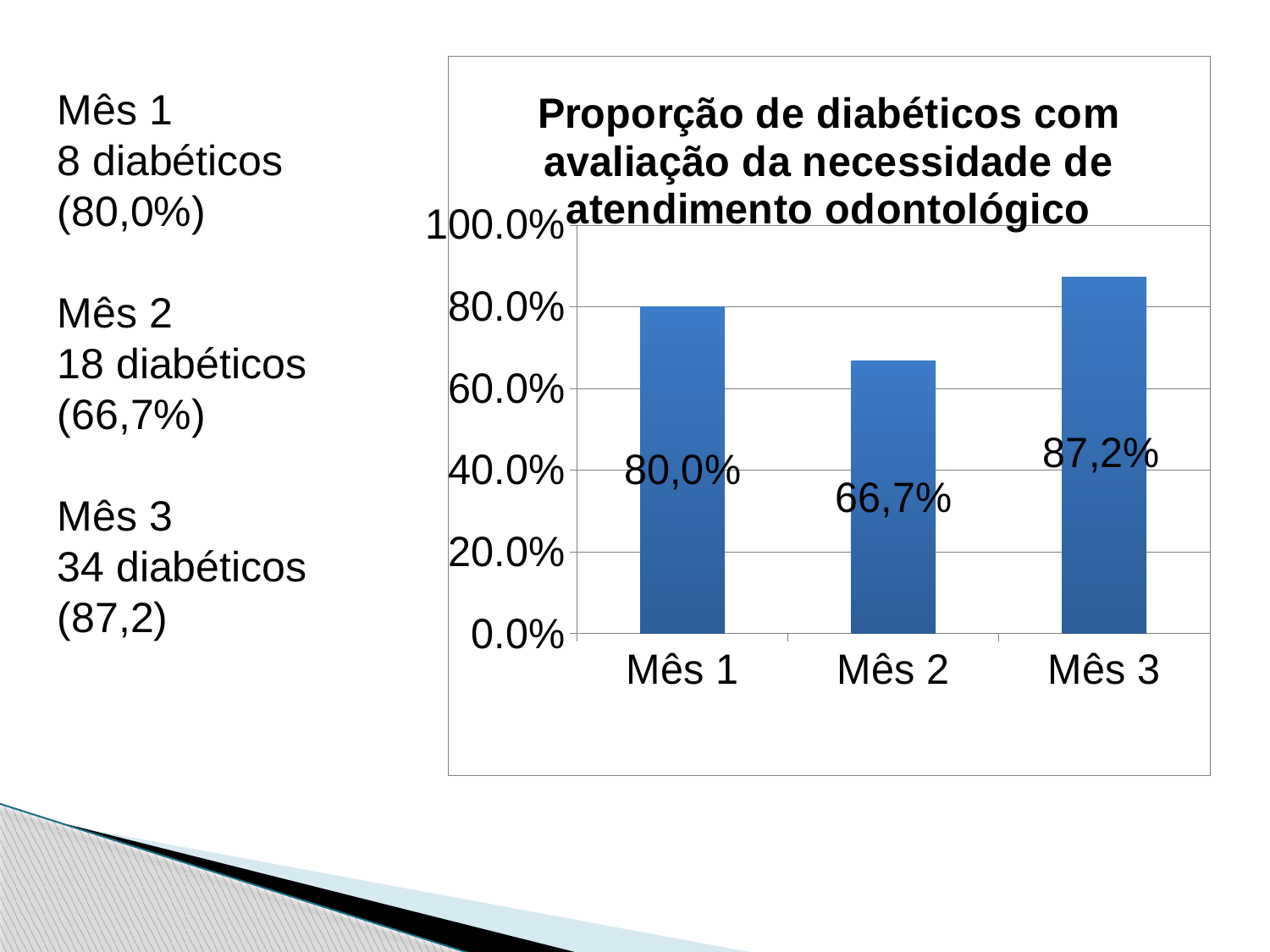
What is the title of the chart? Proporção de diabéticos com avaliação da necessidade de atendimento odontológico Which month has the highest value? Mês 3 What is the value for Mês 3? 87,2% Which is larger, the value for Mês 1 or the value for Mês 2? Mês 1 What is the value for Mês 1? 80,0% What is the difference between the values for Mês 1 and Mês 2? 13,3% What is the value for Mês 2? 66,7% Which month has the lowest value? Mês 2 Is the value for Mês 2 greater or less than 80.0%? less What kind of chart is shown on the slide? bar chart What is the difference between the values for Mês 3 and Mês 1? 7,2% How many months are shown on the x axis? 3